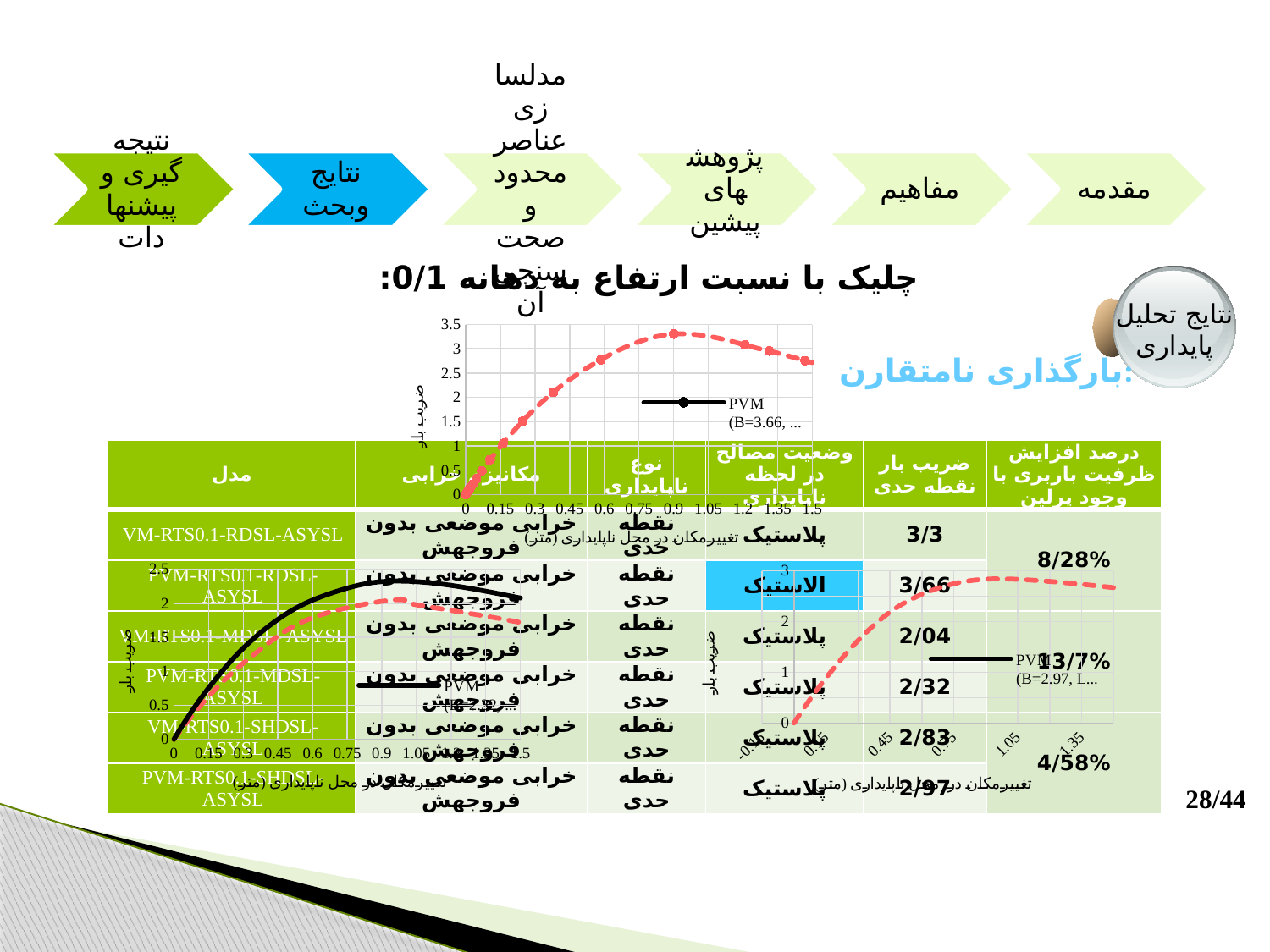
In the top chart, is the value of the dashed curve at x = 0.6 greater or less than 2? greater What kind of chart is the top chart on the slide? line chart What kind of chart is the bottom-right chart on the slide? line chart In the bottom-left chart, which curve reaches a higher peak, the solid black curve or the dashed red curve? solid black curve In the bottom-right chart, is the peak value of the dashed curve greater or less than 2? greater In the bottom-left chart, is the peak value of the solid black curve greater or less than 2? greater In the top chart, how does the dashed curve behave as x increases from 0 to 1.5? rises then falls In the top chart, what is the label on the y axis? ضریب بار In the top chart, what is the highest value shown on the y axis? 3.5